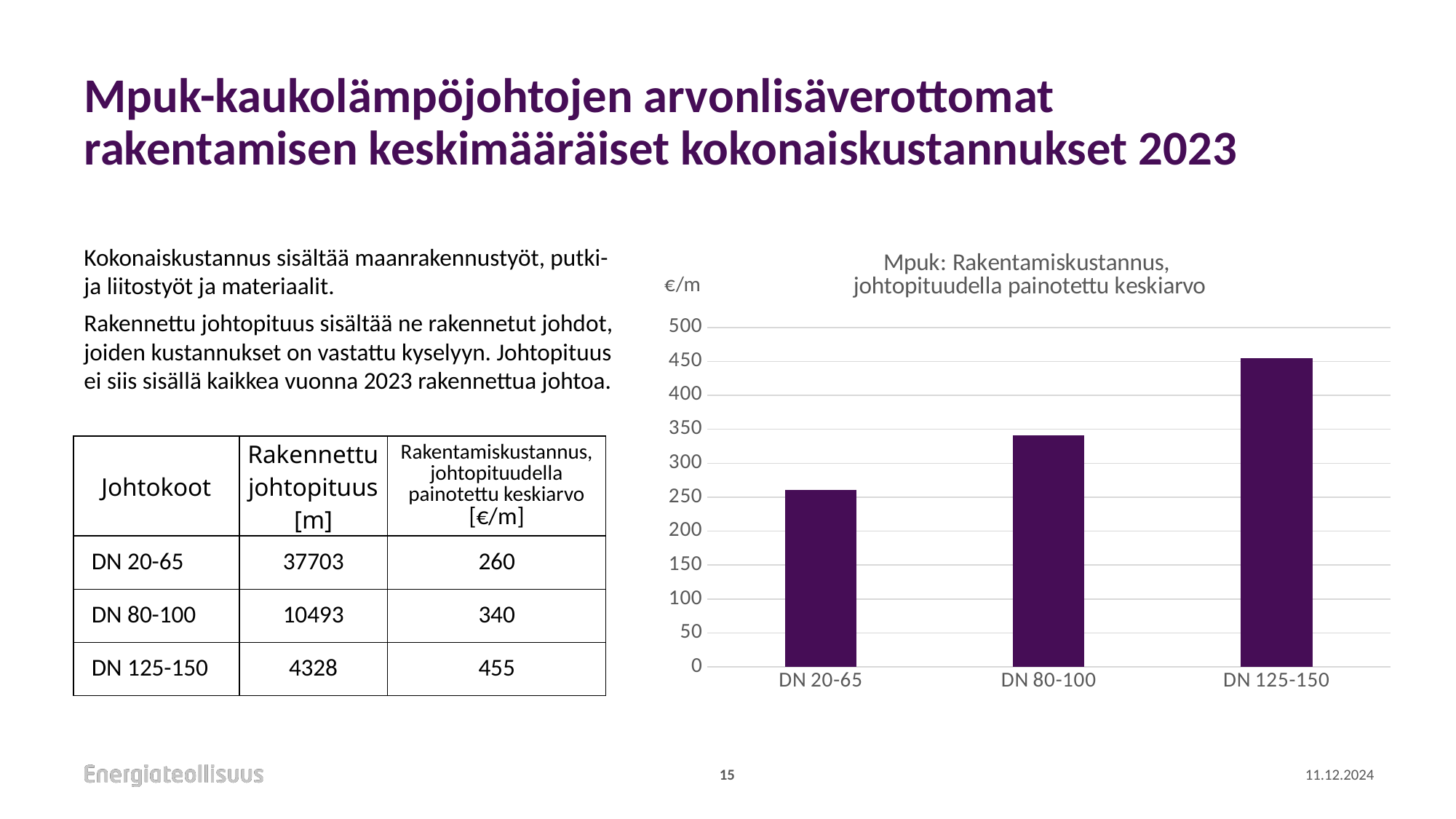
What is the value for DN 20-65 in €/m? 260 Which category has the highest value in the chart? DN 125-150 What is the value for DN 125-150 in €/m? 455 Do the values rise or fall from left to right along the x axis? rise What is the value for DN 80-100 in €/m? 340 Is the value for DN 80-100 greater or less than 300? greater What kind of chart is shown on the slide? bar chart Is the value for DN 20-65 greater or less than 300? less What is the difference between the values for DN 125-150 and DN 20-65? 195 What unit is shown on the vertical axis of the chart? €/m Which category has the lowest value in the chart? DN 20-65 How many categories are plotted in the chart? 3